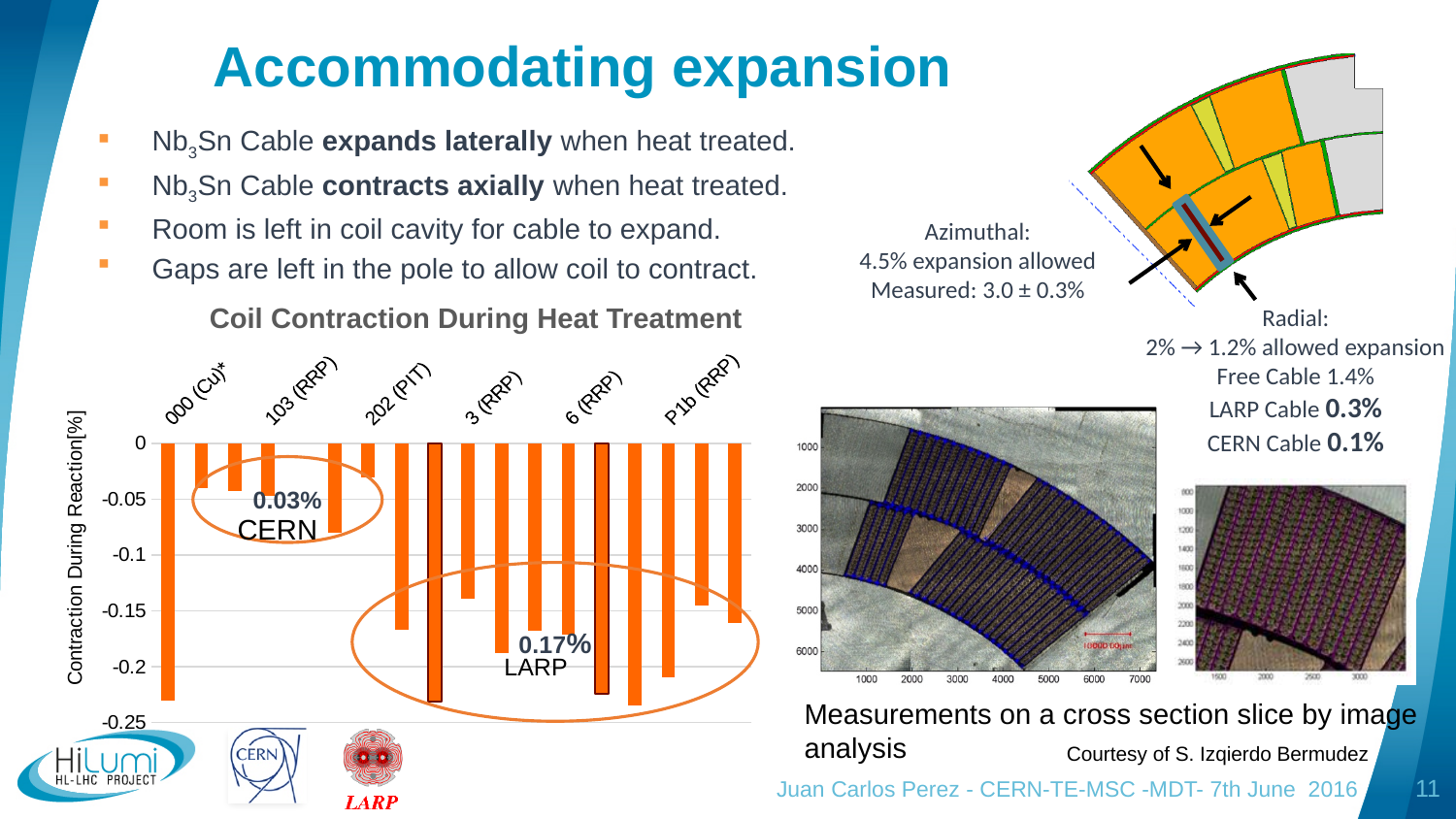
What kind of chart is the Coil Contraction During Heat Treatment chart? bar chart What contraction value is annotated for the LARP group in the Coil Contraction During Heat Treatment chart? 0.17% How many categories are labelled along the x axis of the Coil Contraction During Heat Treatment chart? 6 What is the label of the vertical axis in the Coil Contraction During Heat Treatment chart? Contraction During Reaction[%] What contraction value is annotated for the CERN group in the Coil Contraction During Heat Treatment chart? 0.03% In the Coil Contraction During Heat Treatment chart, what is the difference between the annotated LARP contraction and the annotated CERN contraction? 0.14% In the Coil Contraction During Heat Treatment chart, are the bars in the CERN circled group greater or less than -0.1? greater In the Coil Contraction During Heat Treatment chart, which group shows the larger annotated contraction, CERN or LARP? LARP What is the title of the chart on the left of the slide? Coil Contraction During Heat Treatment In the Coil Contraction During Heat Treatment chart, is the value of the leftmost bar greater or less than -0.2? less